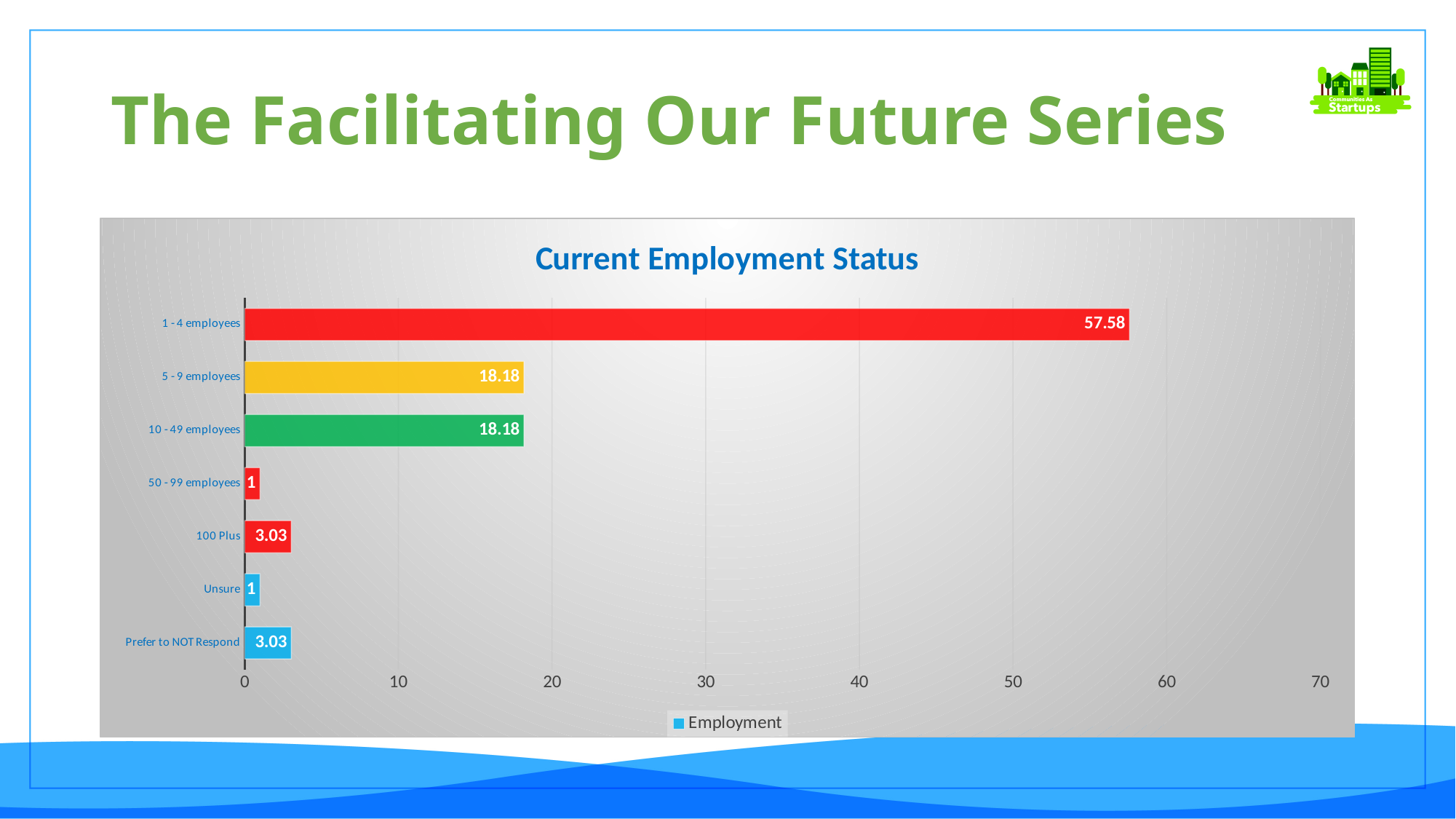
What is the value for Unsure? 1 Which category has the highest value? 1 - 4 employees What is the value for 1 - 4 employees? 57.58 Which is larger, the value for 10 - 49 employees or the value for 100 Plus? 10 - 49 employees What is the value for 5 - 9 employees? 18.18 What is the title of the chart? Current Employment Status What kind of chart is shown on the slide? bar chart What is the difference between the values for 1 - 4 employees and 5 - 9 employees? 39.4 What is the value for 100 Plus? 3.03 What is the difference between the values for 100 Plus and 50 - 99 employees? 2.03 Is the value for 1 - 4 employees greater or less than 50? greater How many categories are shown in the chart? 7